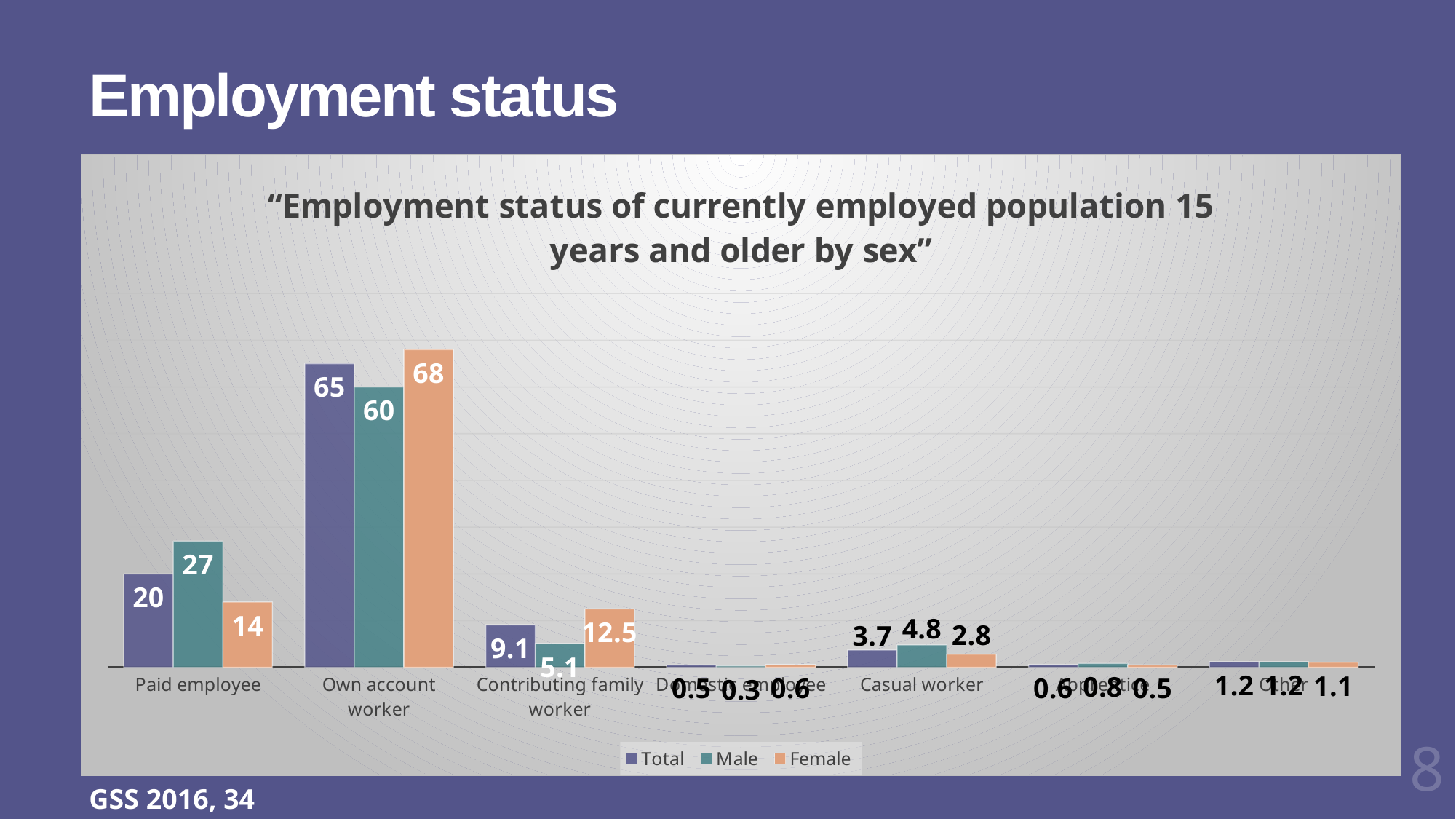
For Contributing family worker, which is larger, the Male value or the Female value? Female How many series does the legend list? 3 What is the Male value for Paid employee? 27 For Casual worker, which is larger, the Total value or the Male value? Male What is the Total value for Contributing family worker? 9.1 What is the title of the chart? "Employment status of currently employed population 15 years and older by sex" What is the Male value for Casual worker? 4.8 Which category has the highest Total value? Own account worker What kind of chart is shown on the slide? Bar chart What is the Female value for Own account worker? 68 What is the difference between the Female and Male values for Own account worker? 8 What is the difference between the Male and Female values for Paid employee? 13